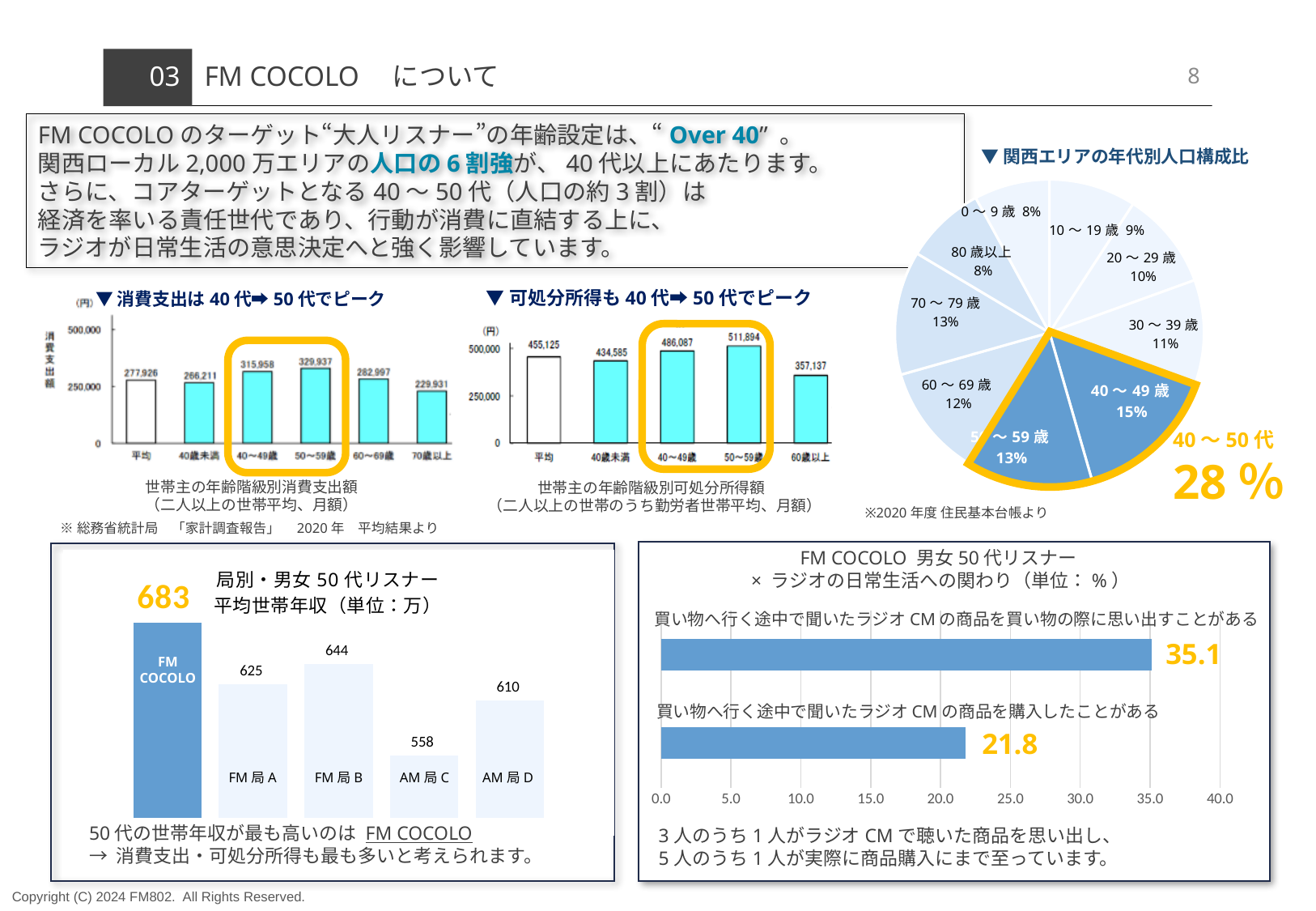
In the chart titled 消費支出は40代➡50代でピーク, which age group has the highest value? 50〜59歳 In the chart titled 局別・男女50代リスナー平均世帯年収, how many stations are plotted? 5 In the chart titled FM COCOLO 男女50代リスナー × ラジオの日常生活への関わり, what is the value for 買い物へ行く途中で聞いたラジオCMの商品を購入したことがある? 21.8 In the chart titled FM COCOLO 男女50代リスナー × ラジオの日常生活への関わり, what kind of chart is used? bar chart In the pie chart titled 関西エリアの年代別人口構成比, what is the share for 80歳以上? 8% In the chart titled 局別・男女50代リスナー平均世帯年収, what is the difference between FM COCOLO and AM局C? 125 In the pie chart titled 関西エリアの年代別人口構成比, which age group has the largest share? 40〜49歳 In the chart titled 可処分所得も40代➡50代でピーク, what is the value for 50〜59歳? 511,894 In the pie chart titled 関西エリアの年代別人口構成比, how many age-group slices are shown? 9 In the pie chart titled 関西エリアの年代別人口構成比, what share of the population is aged 40〜49歳? 15% In the chart titled 局別・男女50代リスナー平均世帯年収, what is the value for FM COCOLO? 683 In the chart titled 局別・男女50代リスナー平均世帯年収, which station has the lowest value? AM局C